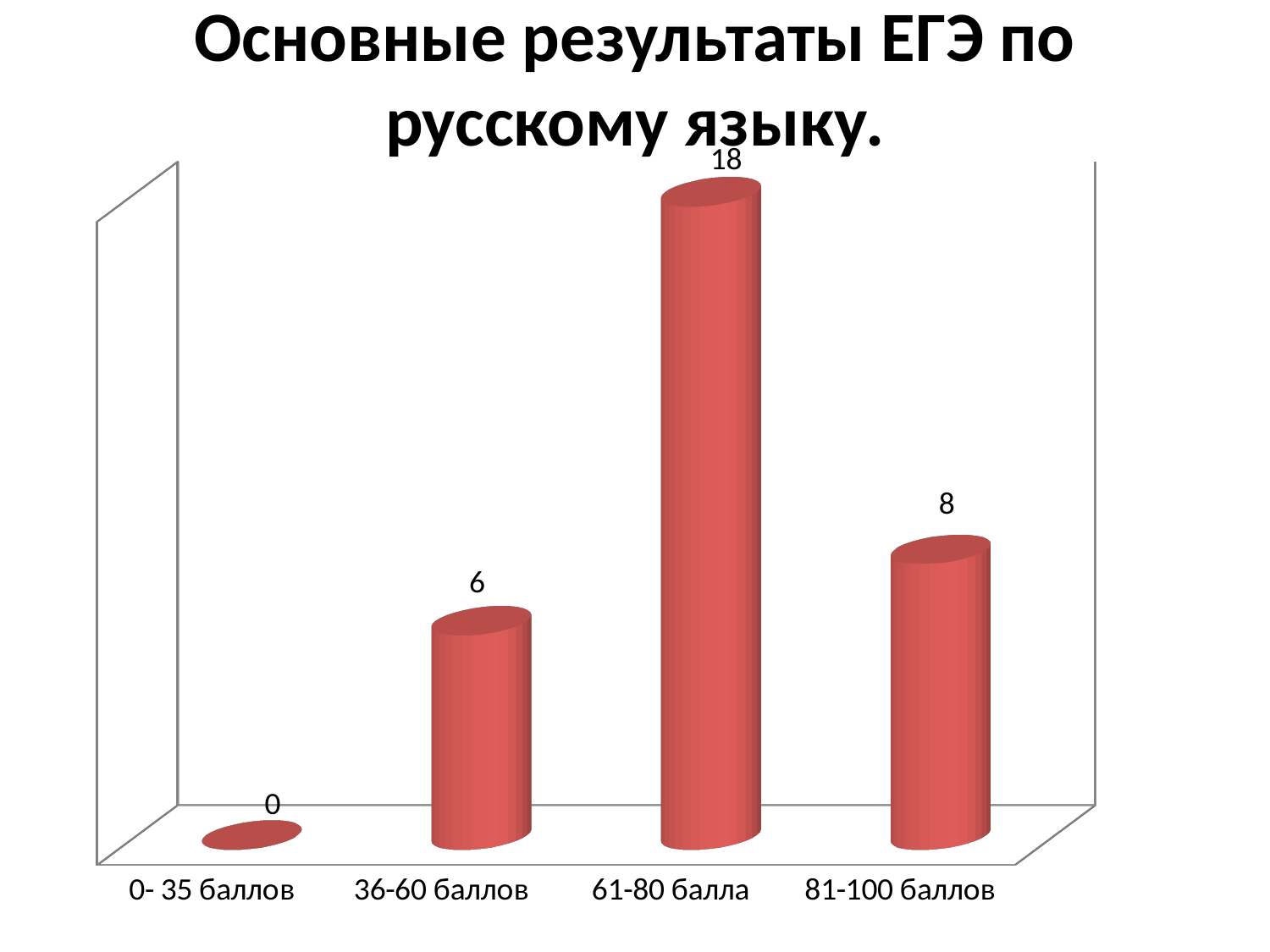
What is the difference between the values for 61-80 балла and 81-100 баллов? 10 Which is larger, the value for 36-60 баллов or the value for 81-100 баллов? 81-100 баллов Which category has the highest value? 61-80 балла How many categories are shown on the chart? 4 What is the value for the 0- 35 баллов category? 0 What is the title of the chart? Основные результаты ЕГЭ по русскому языку. What kind of chart is shown on the slide? bar chart What is the value for the 61-80 балла category? 18 What is the value for the 36-60 баллов category? 6 What is the value for the 81-100 баллов category? 8 Which category has the lowest value? 0- 35 баллов What is the difference between the values for 81-100 баллов and 36-60 баллов? 2